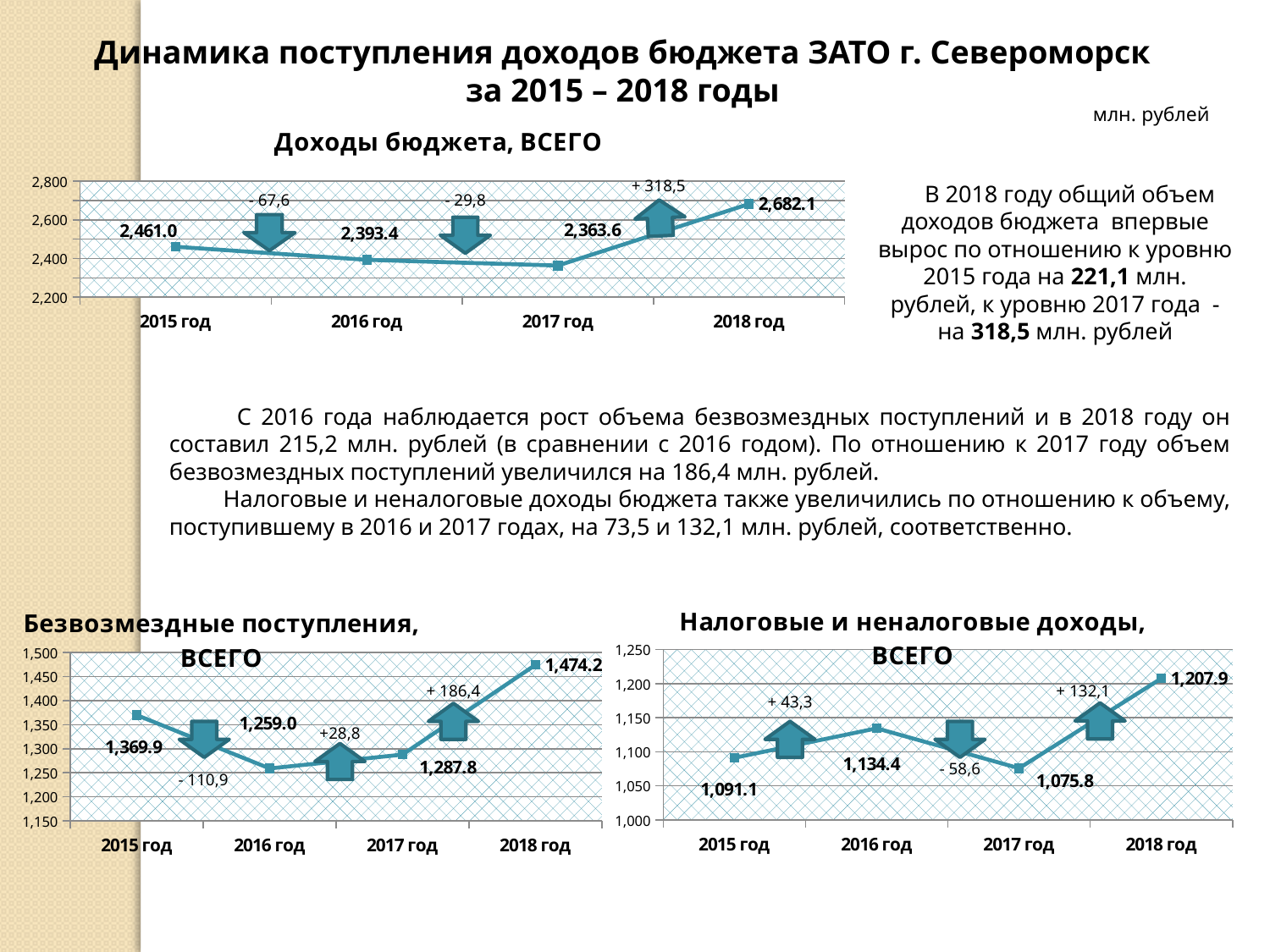
In the chart 'Доходы бюджета, ВСЕГО', which year has the lowest value? 2017 год In the chart 'Налоговые и неналоговые доходы, ВСЕГО', what is the value for 2017 год? 1,075.8 In the chart 'Доходы бюджета, ВСЕГО', what is the value for 2018 год? 2,682.1 In the chart 'Безвозмездные поступления, ВСЕГО', which year has the highest value? 2018 год In the chart 'Налоговые и неналоговые доходы, ВСЕГО', what is the difference between the values for 2018 год and 2015 год? 116.8 In the chart 'Налоговые и неналоговые доходы, ВСЕГО', which is larger, the value for 2016 год or 2015 год? 2016 год In the chart 'Налоговые и неналоговые доходы, ВСЕГО', does the value rise or fall from 2017 год to 2018 год? rise In the chart 'Безвозмездные поступления, ВСЕГО', what is the value for 2016 год? 1,259.0 In the chart 'Безвозмездные поступления, ВСЕГО', is the value for 2015 год greater or less than 1,350? greater In the chart 'Доходы бюджета, ВСЕГО', what is the difference between the values for 2018 год and 2017 год? 318.5 In the chart 'Безвозмездные поступления, ВСЕГО', how many years are plotted? 4 What kind of chart is 'Доходы бюджета, ВСЕГО'? line chart